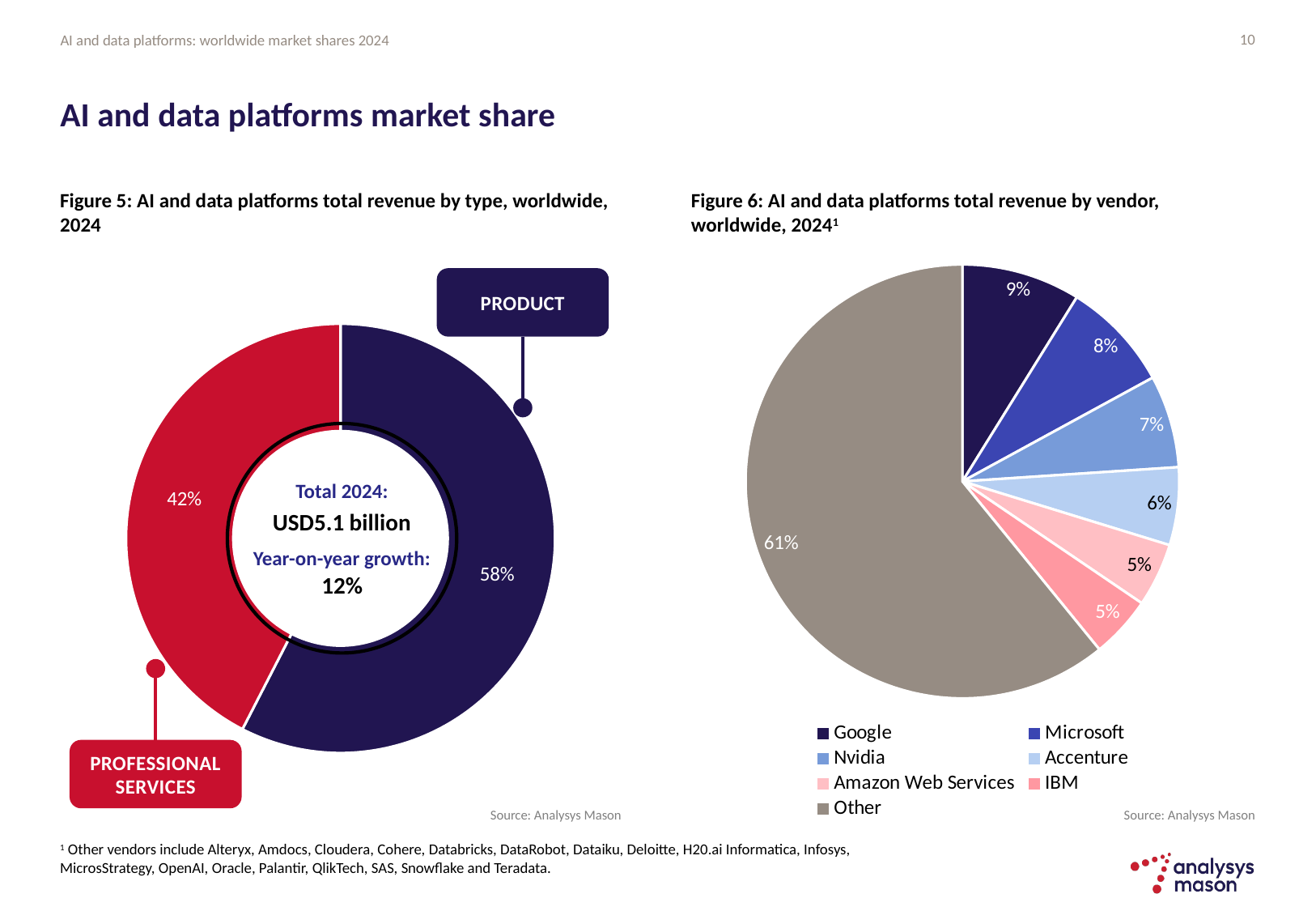
In Figure 5, what year-on-year growth is shown in the centre of the chart? 12% In Figure 6, how many entries does the legend list? 7 In Figure 6, what share of revenue does Accenture have? 6% In Figure 5, what is the difference in percentage points between the Product and Professional Services shares? 16 percentage points In Figure 5, what share of total revenue comes from Product? 58% In Figure 6, what share of revenue does Google have? 9% In Figure 6, which vendor category has the largest share? Other In Figure 5, what share of total revenue comes from Professional Services? 42% In Figure 6, what is the difference in percentage points between Google's share and Nvidia's share? 2 percentage points In Figure 6, what share of revenue does Microsoft have? 8% In Figure 5, which type has the larger share of revenue, Product or Professional Services? Product In Figure 5, what is the total 2024 revenue shown in the centre of the chart? USD5.1 billion